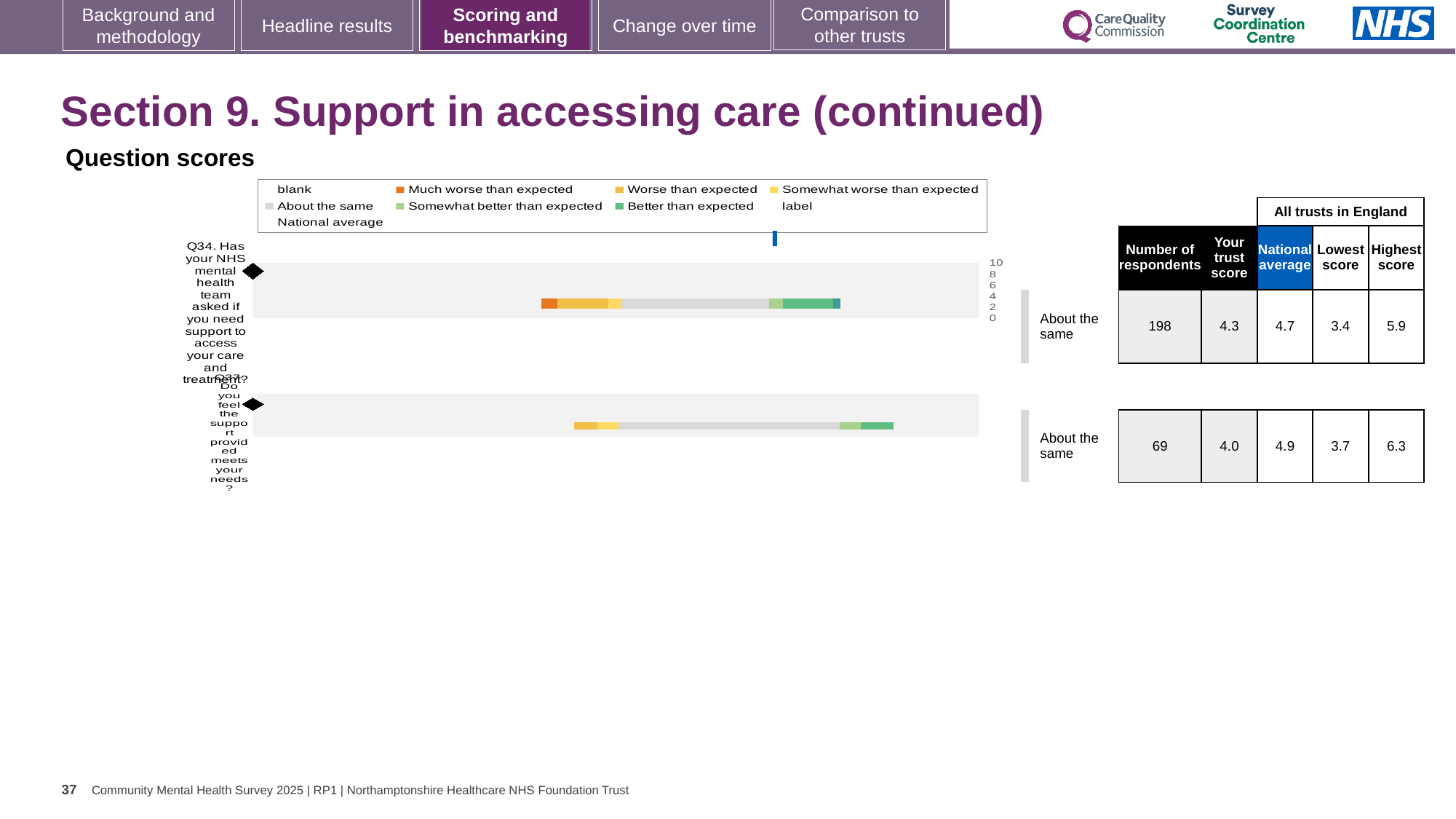
What is the national average score for Q34? 4.7 What is the highest score among all trusts in England for Q37? 6.3 What is the difference between the highest score and the lowest score for Q34? 2.5 What benchmark category is shown for Q34? About the same Which question has the higher trust score, Q34 or Q37? Q34 Which colour in the legend represents 'Much worse than expected'? Orange What is the trust score for Q34 (Has your NHS mental health team asked if you need support to access your care and treatment)? 4.3 How many respondents answered Q37 (Do you feel the support provided meets your needs)? 69 What kind of chart is used to show the question scores on this slide? Bar chart Which question has the higher national average score? Q37 By how much does the national average exceed the trust score for Q37? 0.9 How many questions are plotted in the question scores chart? 2